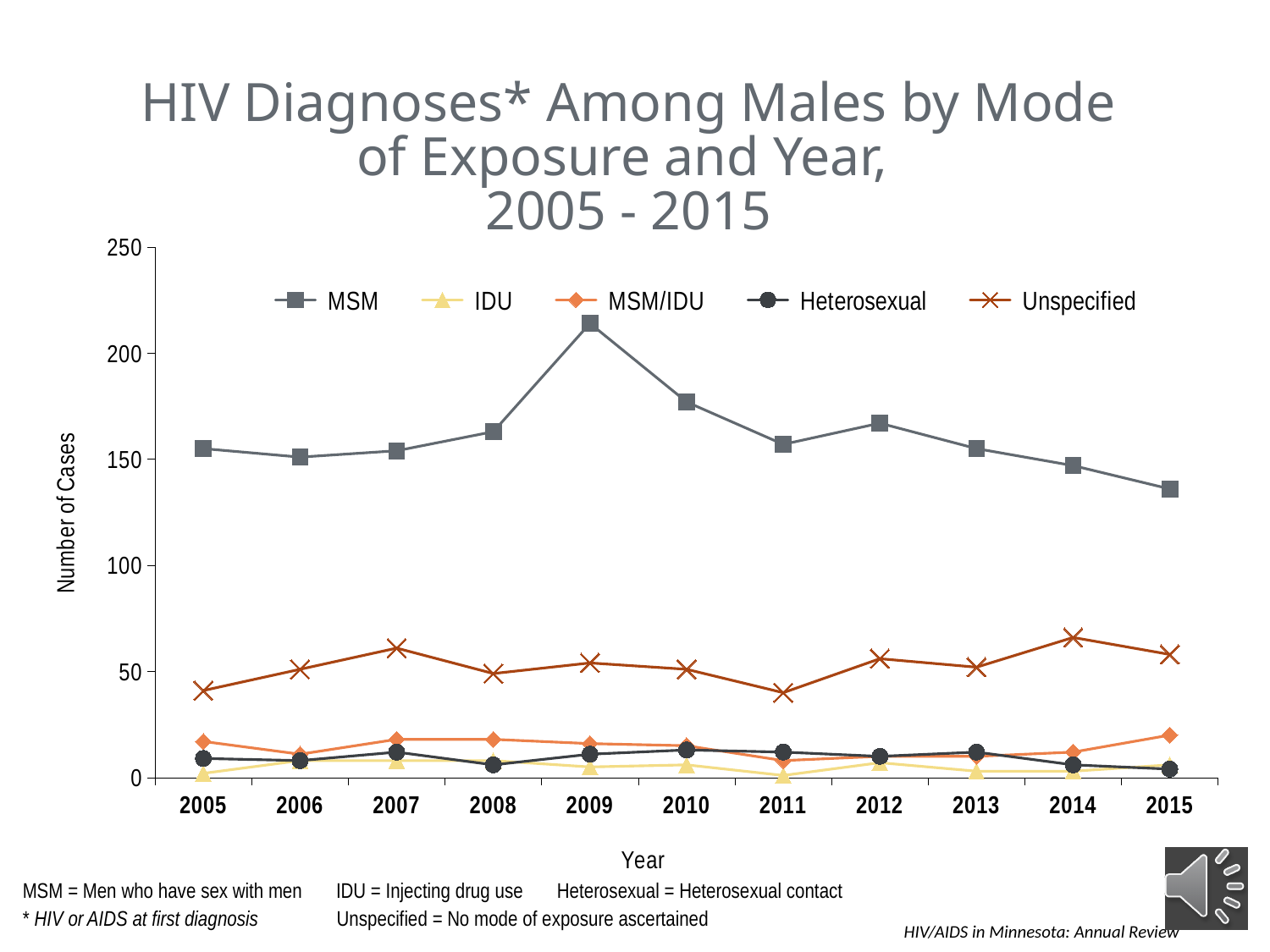
Is the value for Unspecified in 2011 greater or less than 50? less What is the label on the y axis? Number of Cases Which series has the larger value in 2009, MSM or Unspecified? MSM In which year does the MSM series reach its highest value? 2009 In which year does the MSM series reach its lowest value? 2015 Is the value for MSM in 2009 greater or less than 200? greater Is the value for MSM in 2015 greater or less than 150? less Does the MSM series rise or fall from 2009 to 2015? fall In which year does the Unspecified series reach its lowest value? 2011 How many series does the legend list? 5 What kind of chart is shown on the slide? line chart How many years are plotted along the x axis? 11